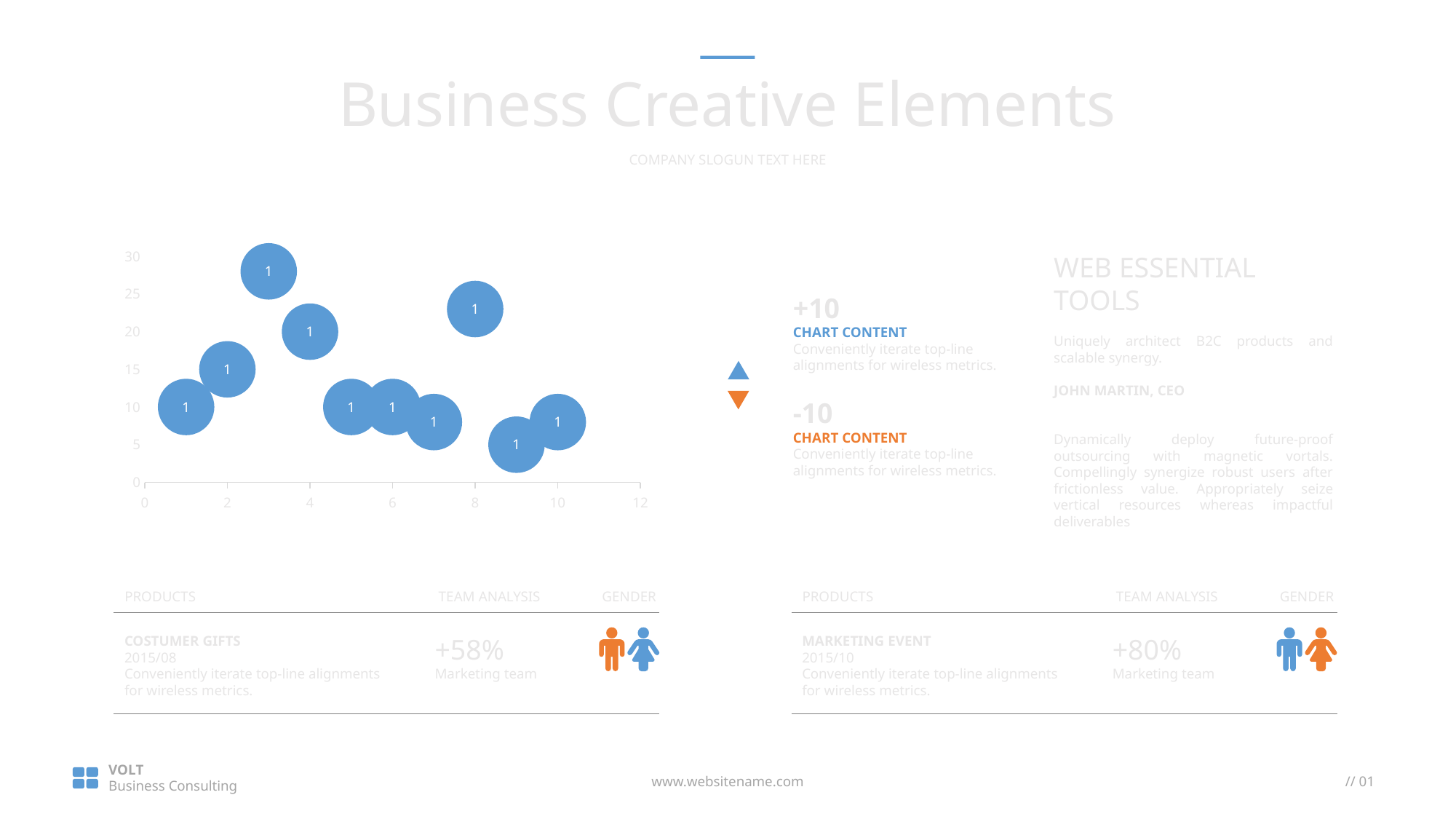
Is the y value of the bubble at x = 9 greater or less than 10? less What colour are the bubbles in the chart? blue Is the y value of the bubble at x = 8 greater or less than 20? greater How many bubbles are plotted in the chart? 10 Is the y value of the bubble at x = 3 greater or less than 25? greater At which x-axis value is the highest bubble on the chart located? 3 Which bubble is higher on the y axis, the one at x = 2 or the one at x = 7? the one at x = 2 What kind of chart is shown on the left of the slide? bubble chart Which bubble is higher on the y axis, the one at x = 3 or the one at x = 8? the one at x = 3 What data label is printed on each bubble in the chart? 1 What is the highest tick value shown on the chart's y axis? 30 At which x-axis value is the lowest bubble on the chart located? 9